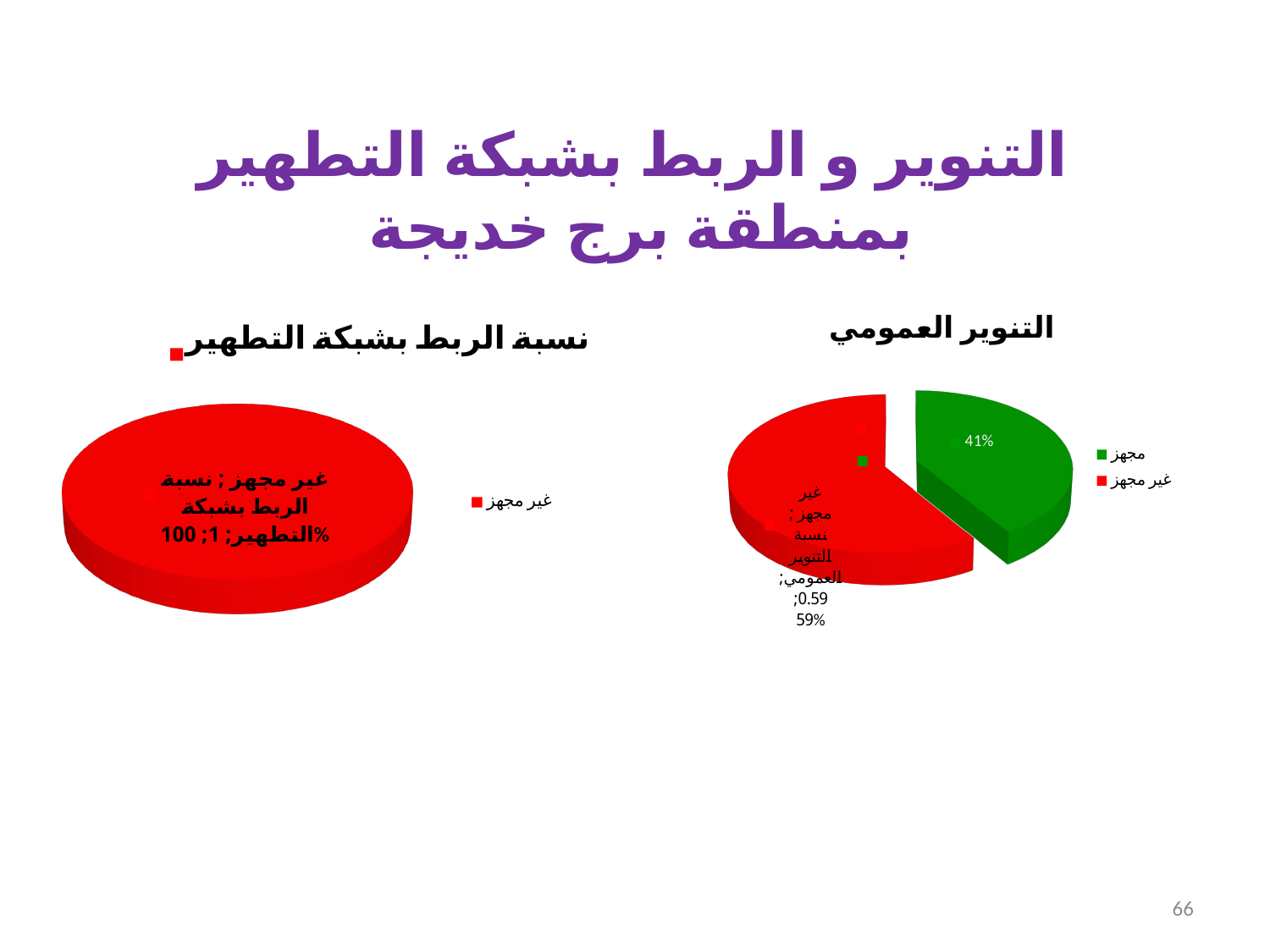
In the chart titled التنوير العمومي, which is larger: مجهز or غير مجهز? غير مجهز In the chart titled التنوير العمومي, what share of the pie is مجهز? 41% How many charts are shown on the slide? 2 In the chart titled التنوير العمومي, what share of the pie is غير مجهز? 59% In the chart titled نسبة الربط بشبكة التطهير, what share of the pie is غير مجهز? 100% What kind of chart is the chart titled التنوير العمومي? Pie chart In the chart titled التنوير العمومي, which category has the smallest slice? مجهز In the chart titled نسبة الربط بشبكة التطهير, how many slices does the pie have? 1 In the chart titled التنوير العمومي, what colour is the مجهز slice? Green In the chart titled التنوير العمومي, which category has the largest slice? غير مجهز In the chart titled التنوير العمومي, what is the difference in percentage points between غير مجهز and مجهز? 18 In the chart titled التنوير العمومي, how many categories does the legend list? 2